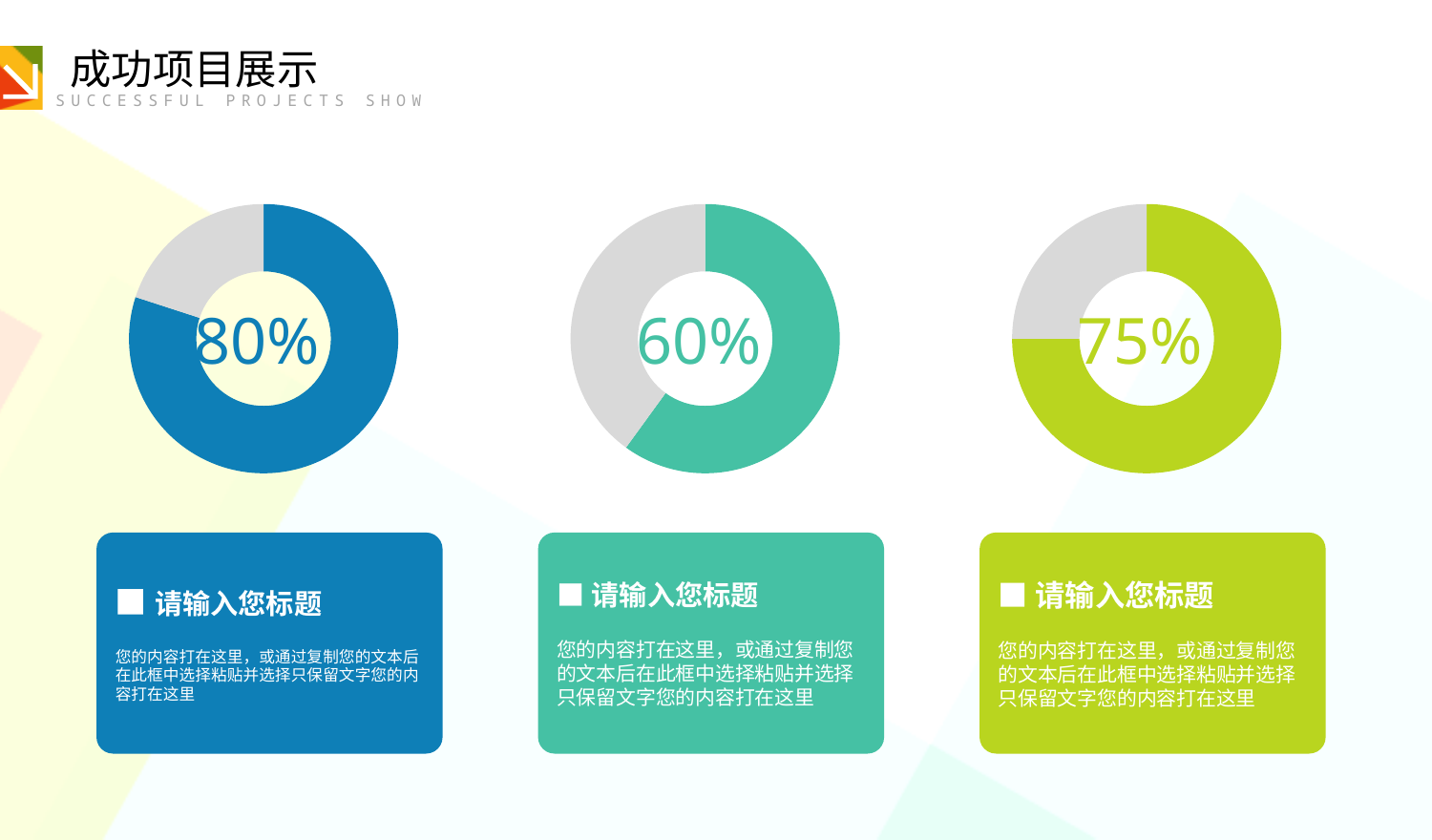
What kind of chart is used to display the percentages on this slide? donut chart What percentage is shown in the left donut chart? 80% Which of the three donut charts shows the lowest percentage: left, middle or right? middle Which of the three donut charts shows the highest percentage: left, middle or right? left How many donut charts are on the slide? 3 What percentage is shown in the middle donut chart? 60% What colour is the filled portion of the left donut chart? blue What colour is the filled portion of the middle donut chart? green What is the difference between the percentage in the right donut chart and the percentage in the middle donut chart? 15% What is the difference between the percentage in the left donut chart and the percentage in the middle donut chart? 20% What percentage is shown in the right donut chart? 75% Is the percentage in the left donut chart larger or smaller than the percentage in the right donut chart? larger